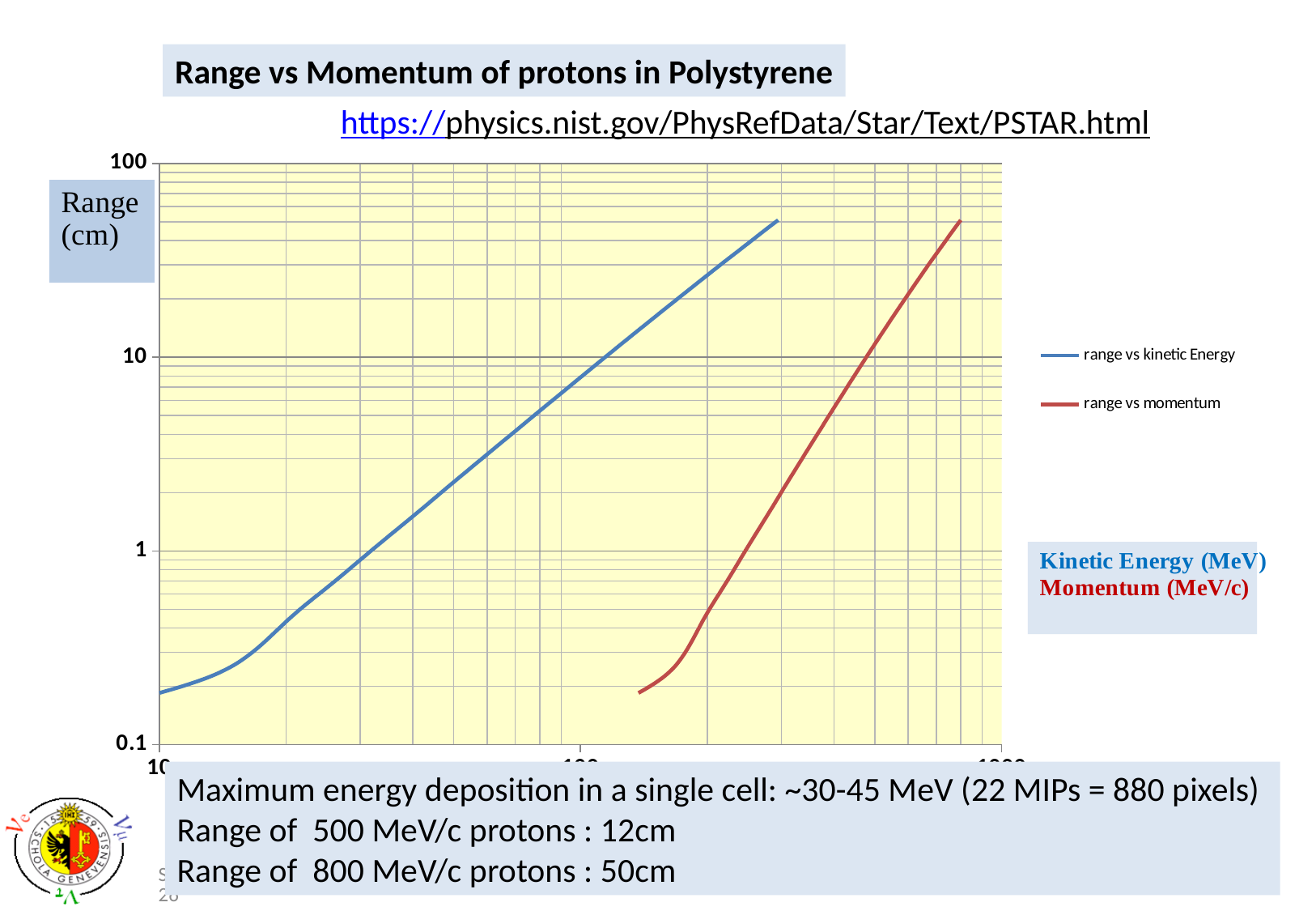
At x = 300, which series has the larger range value, range vs kinetic Energy or range vs momentum? range vs kinetic Energy Is the range vs kinetic Energy value at x = 10 greater or less than 1? less Which series is drawn in red? range vs momentum What is the highest tick value shown on the y axis? 100 What kind of chart is shown on the slide? line chart How many series does the legend list? 2 Does the range vs momentum series rise or fall as the x axis increases? rise What is the title of the chart? Range vs Momentum of protons in Polystyrene Does the range vs kinetic Energy series rise or fall as the x axis increases? rise Is the range vs momentum value at x = 200 greater or less than 1? less Is the highest value reached by the range vs momentum series greater or less than 10? greater